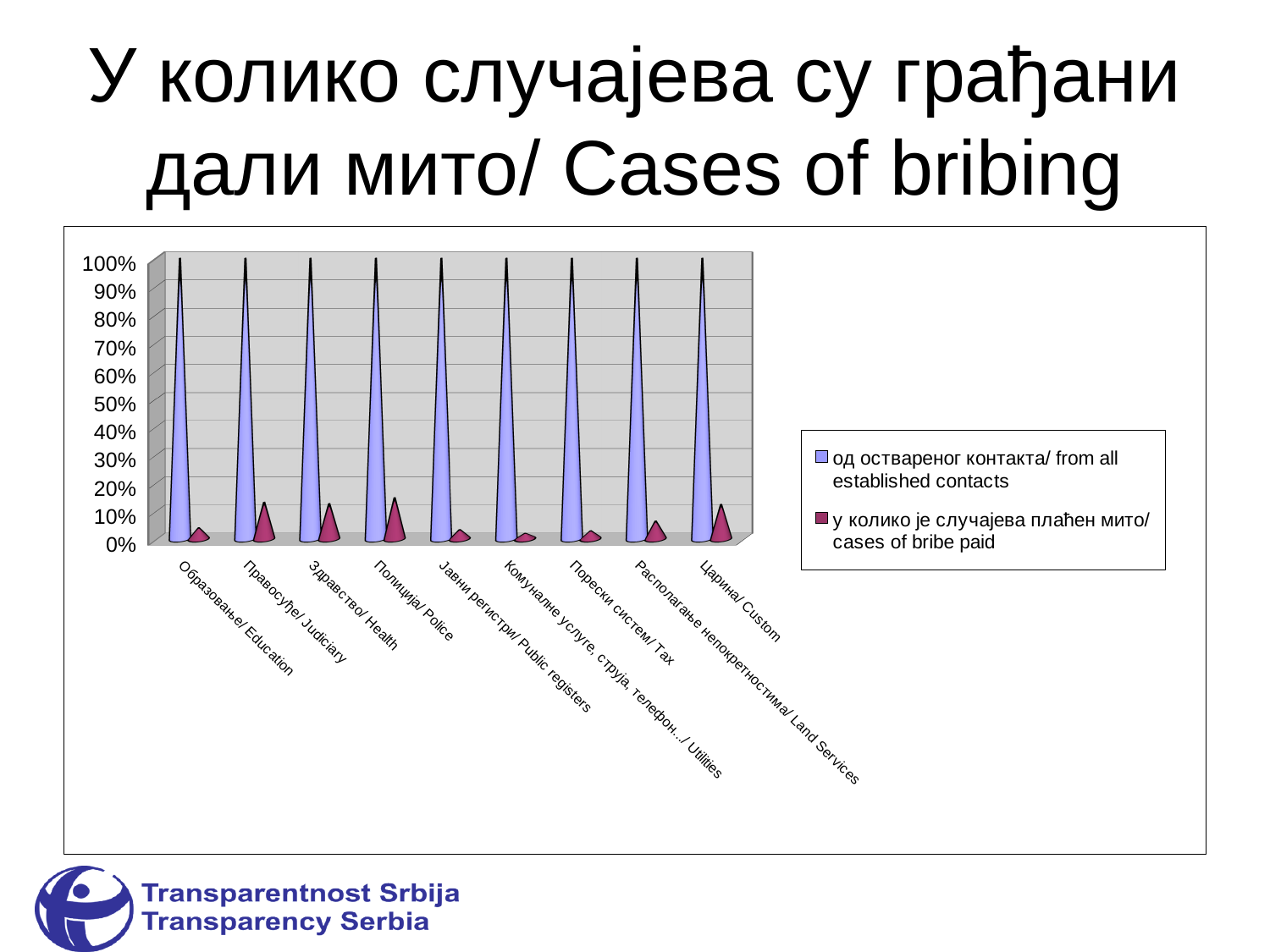
What is the English part of the second legend entry in the chart? cases of bribe paid How many categories are shown on the x axis of the chart? 9 How many series does the chart's legend list? 2 Is the 'cases of bribe paid' value for Правосуђе/ Judiciary greater or less than 10%? greater What is the value of the 'from all established contacts' series for Царина/ Custom? 100% What kind of chart is shown on the slide? bar chart Is the 'cases of bribe paid' value for Полиција/ Police greater or less than 10%? greater What is the value of the 'from all established contacts' series for Образовање/ Education? 100% Which has a higher 'cases of bribe paid' value, Правосуђе/ Judiciary or Порески систем/ Tax? Правосуђе/ Judiciary Which has a higher 'cases of bribe paid' value, Полиција/ Police or Образовање/ Education? Полиција/ Police Is the 'cases of bribe paid' value for Комуналне услуге, струја, телефон.../ Utilities greater or less than 10%? less